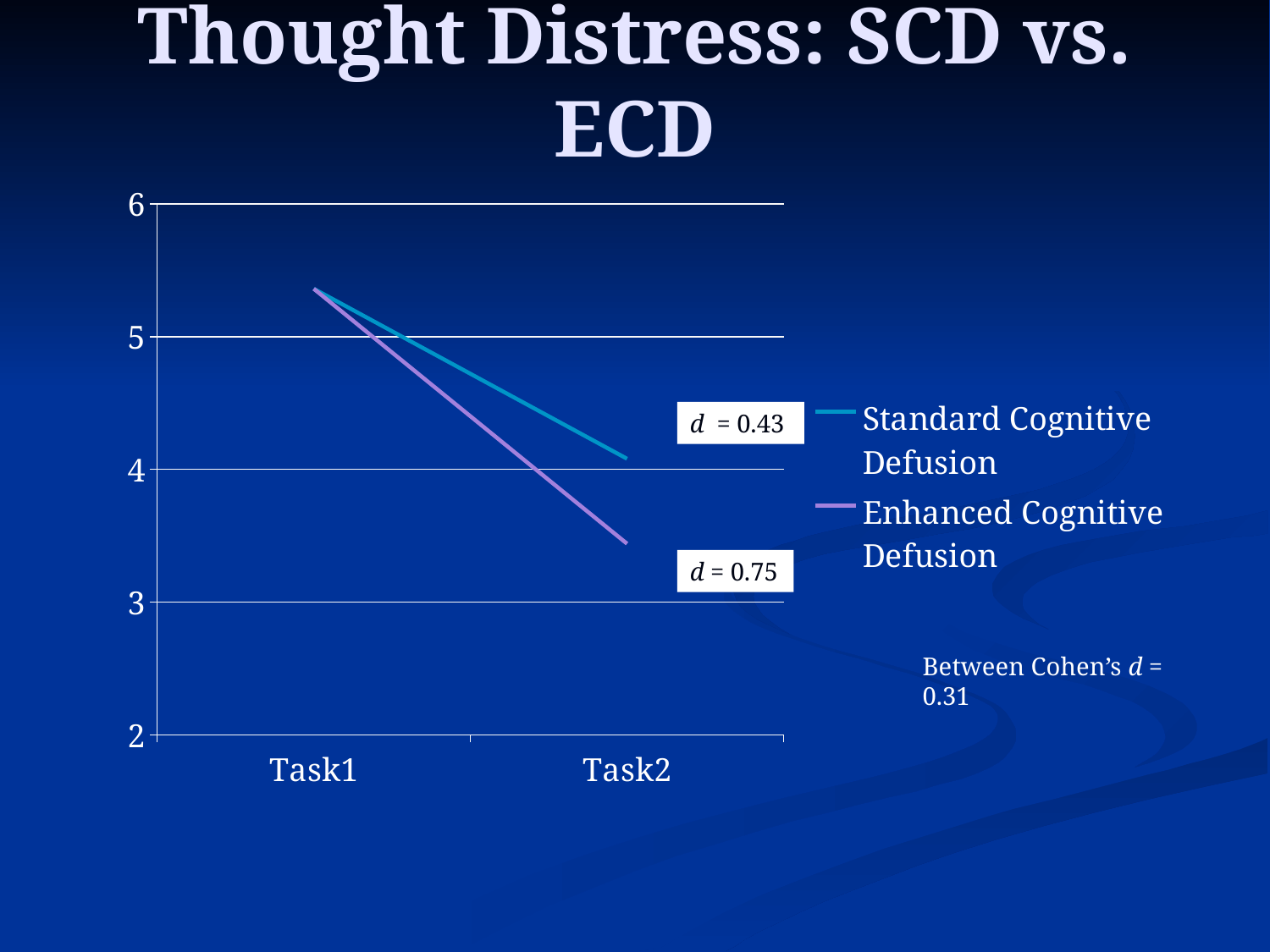
Do the values for Enhanced Cognitive Defusion rise or fall from Task1 to Task2? fall What is the title of the chart? Thought Distress: SCD vs. ECD Do the values for Standard Cognitive Defusion rise or fall from Task1 to Task2? fall Is the value for Enhanced Cognitive Defusion at Task1 greater or less than 5? greater What kind of chart is shown on the slide? line chart Is the value for Enhanced Cognitive Defusion at Task2 greater or less than 3? greater How many categories are shown on the x axis? 2 What Cohen's d value is annotated next to the Enhanced Cognitive Defusion line? d = 0.75 At Task2, which series has the lower value, Standard Cognitive Defusion or Enhanced Cognitive Defusion? Enhanced Cognitive Defusion How many series does the legend list? 2 Is the value for Standard Cognitive Defusion at Task2 greater or less than 5? less